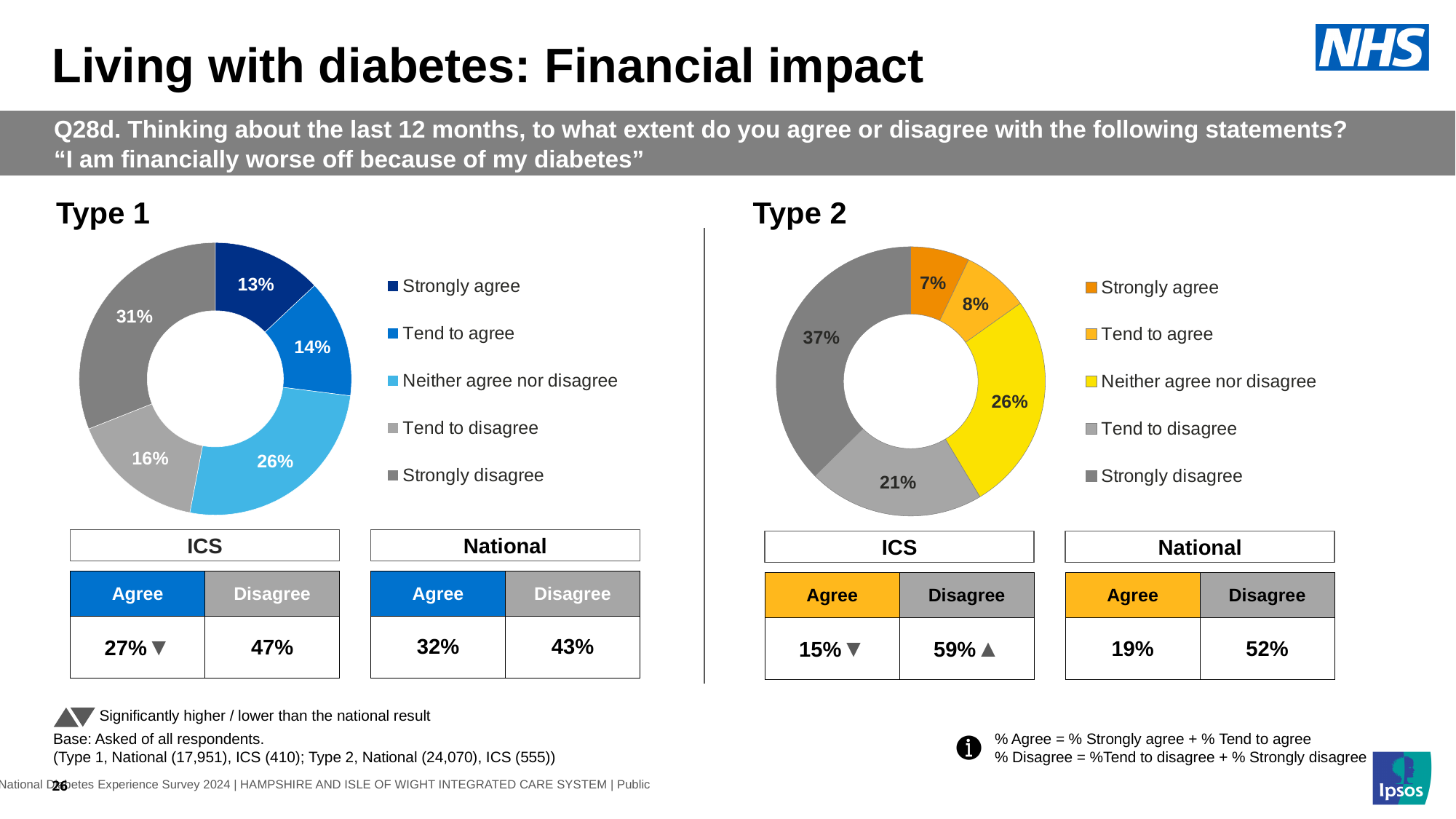
In the Type 2 chart, what colour represents 'Neither agree nor disagree'? Yellow In the Type 2 chart, which response category has the smallest share? Strongly agree In the Type 2 chart, what share of the pie is 'Strongly disagree'? 37% In the Type 1 chart, what percentage of respondents said 'Strongly agree'? 13% In the Type 2 chart, what is the difference between the 'Strongly disagree' and 'Tend to disagree' shares? 16% In the Type 1 chart, what is the difference between the 'Neither agree nor disagree' and 'Tend to agree' shares? 12% What kind of chart is used for Type 2? Doughnut chart In the Type 1 chart, what is the combined share of 'Strongly agree' and 'Tend to agree'? 27% In the Type 1 chart, which is larger: 'Tend to agree' or 'Tend to disagree'? Tend to disagree How many response categories does the Type 1 chart's legend list? 5 In the Type 2 chart, what percentage of respondents said 'Neither agree nor disagree'? 26% In the Type 1 chart, which response category has the largest share? Strongly disagree